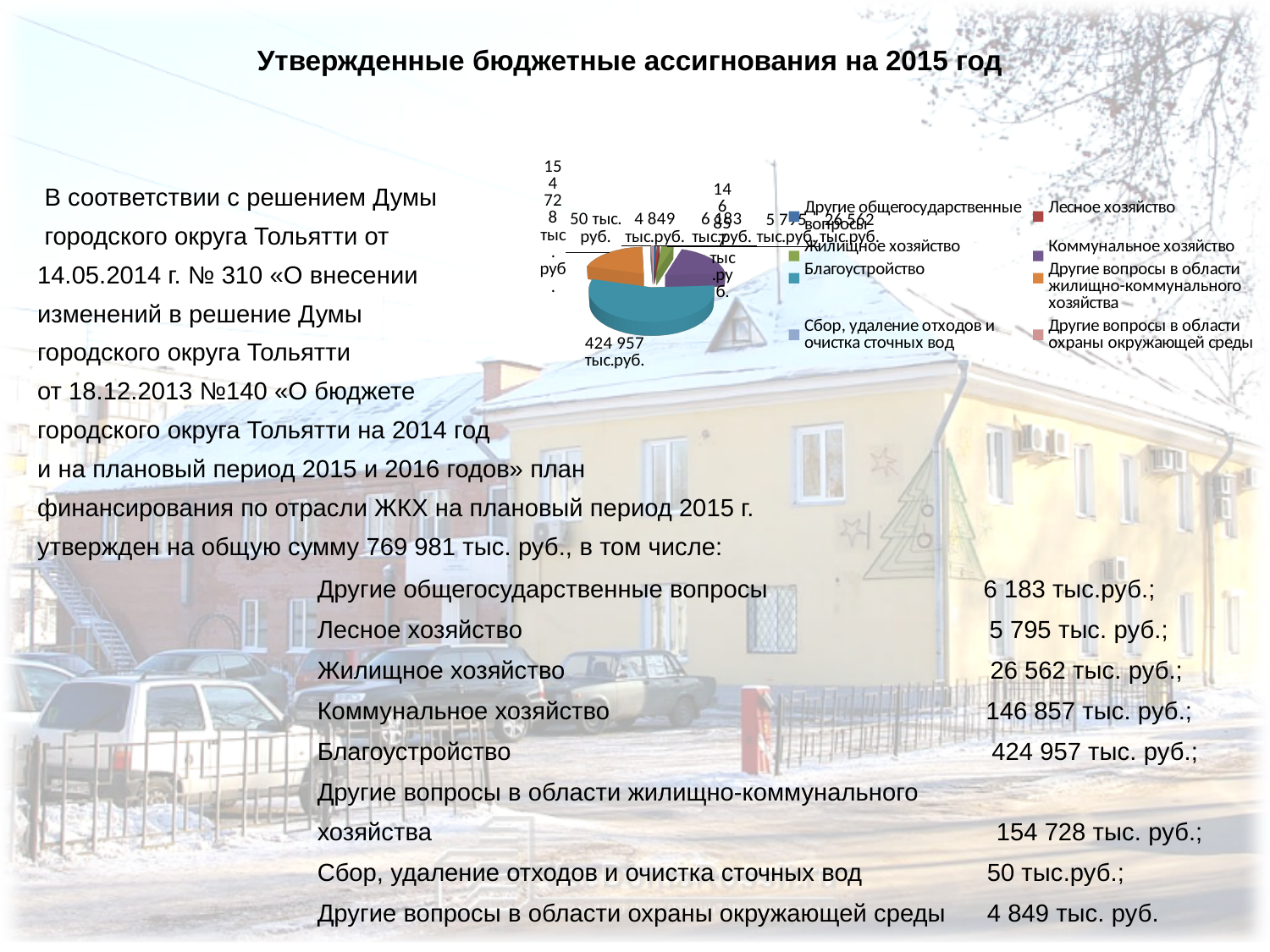
Which category has the smallest slice in the pie chart? Сбор, удаление отходов и очистка сточных вод What is the difference between the values for Благоустройство and Другие вопросы в области жилищно-коммунального хозяйства? 270 229 тыс.руб. What is the value for Коммунальное хозяйство in the pie chart? 146 857 тыс.руб. What is the title of the slide containing the pie chart? Утвержденные бюджетные ассигнования на 2015 год Which is larger: Коммунальное хозяйство or Другие вопросы в области жилищно-коммунального хозяйства? Другие вопросы в области жилищно-коммунального хозяйства What is the value for Другие вопросы в области охраны окружающей среды in the pie chart? 4 849 тыс.руб. What is the value for Благоустройство in the pie chart? 424 957 тыс.руб. What is the value for Сбор, удаление отходов и очистка сточных вод in the pie chart? 50 тыс.руб. Which category has the largest slice in the pie chart? Благоустройство How many categories does the pie chart legend list? 8 What kind of chart is shown on the slide? Pie chart What is the difference between the values for Другие общегосударственные вопросы and Лесное хозяйство? 388 тыс.руб.